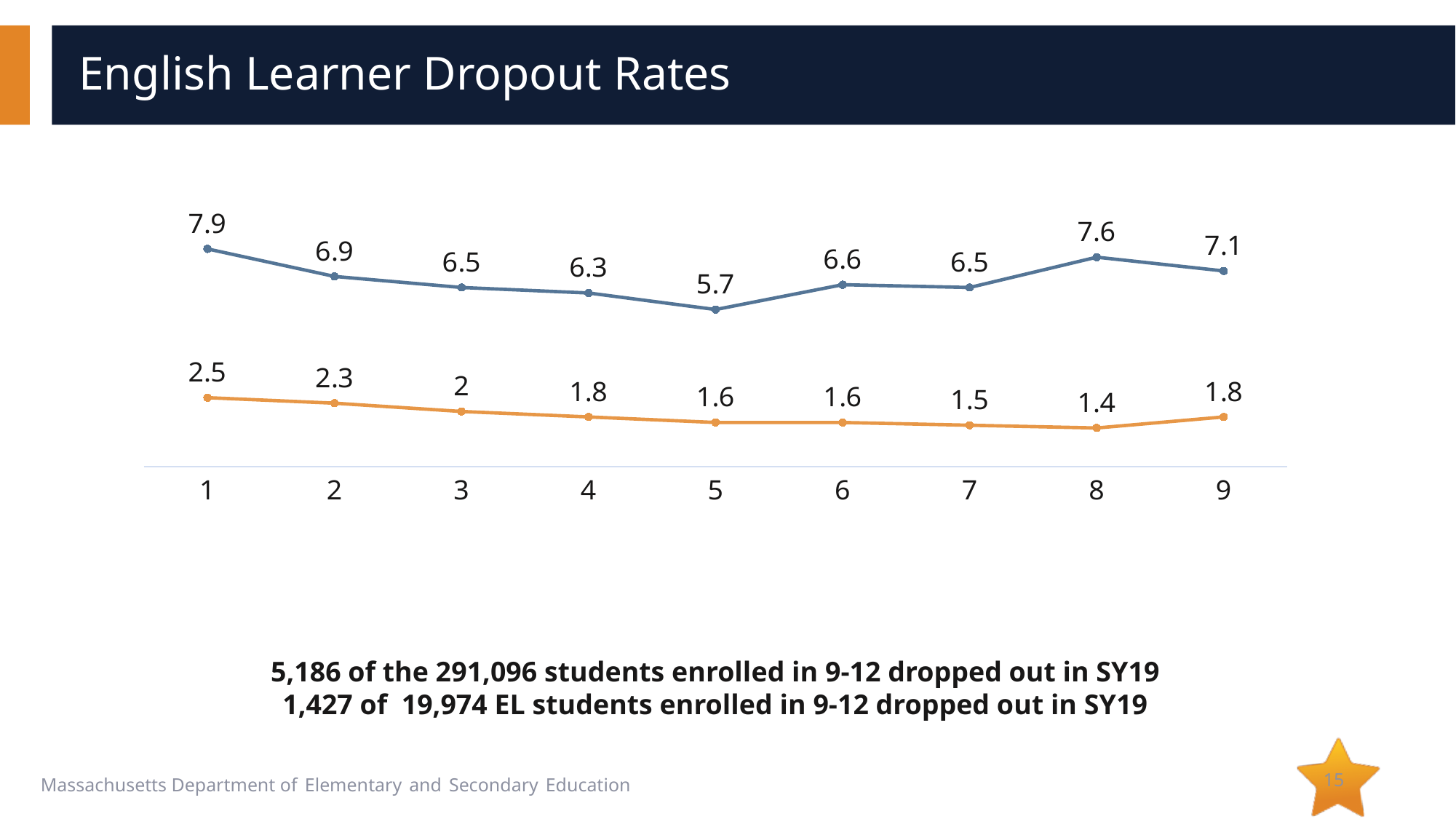
What kind of chart is shown on the slide? Line chart Which is larger: the orange line's value at point 3 or at point 9? Point 3 Does the orange line rise or fall from point 1 to point 8? Fall How many points are plotted along the x axis? 9 At which point does the blue line reach its lowest value? 5 At which point does the orange line reach its lowest value? 8 What is the value of the orange line at point 5? 1.6 At which point is the blue line highest? 1 What is the value of the blue line at point 1? 7.9 What is the difference between the blue line and the orange line at point 1? 5.4 What is the value of the blue line at point 8? 7.6 What is the difference between the blue line's value at point 1 and its value at point 5? 2.2